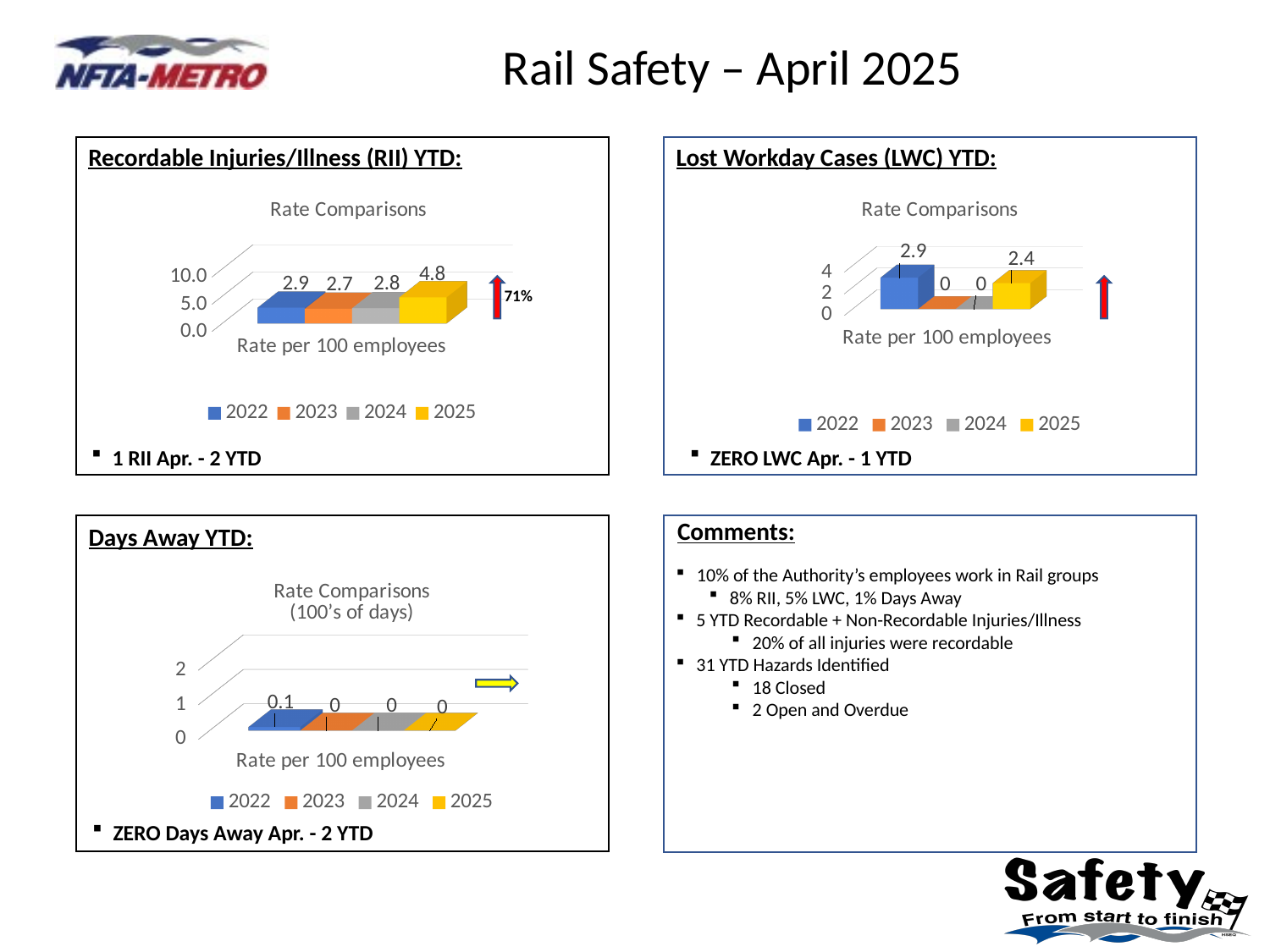
In the Days Away YTD chart, what is the value for 2025? 0 In the Lost Workday Cases (LWC) YTD chart, which is larger, the 2022 value or the 2025 value? 2022 In the Recordable Injuries/Illness (RII) YTD chart, what is the difference between the 2025 and 2024 values? 2.0 What kind of chart is the Days Away YTD chart? Bar chart In the Lost Workday Cases (LWC) YTD chart, what is the value for 2025? 2.4 In the Recordable Injuries/Illness (RII) YTD chart, what is the value for 2025? 4.8 In the Lost Workday Cases (LWC) YTD chart, what is the value for 2022? 2.9 In the Lost Workday Cases (LWC) YTD chart, what is the difference between the 2022 and 2025 values? 0.5 In the Recordable Injuries/Illness (RII) YTD chart, how many series does the legend list? 4 In the Days Away YTD chart, what is the value for 2022? 0.1 In the Recordable Injuries/Illness (RII) YTD chart, which year has the highest rate? 2025 In the Recordable Injuries/Illness (RII) YTD chart, what is the value for 2023? 2.7